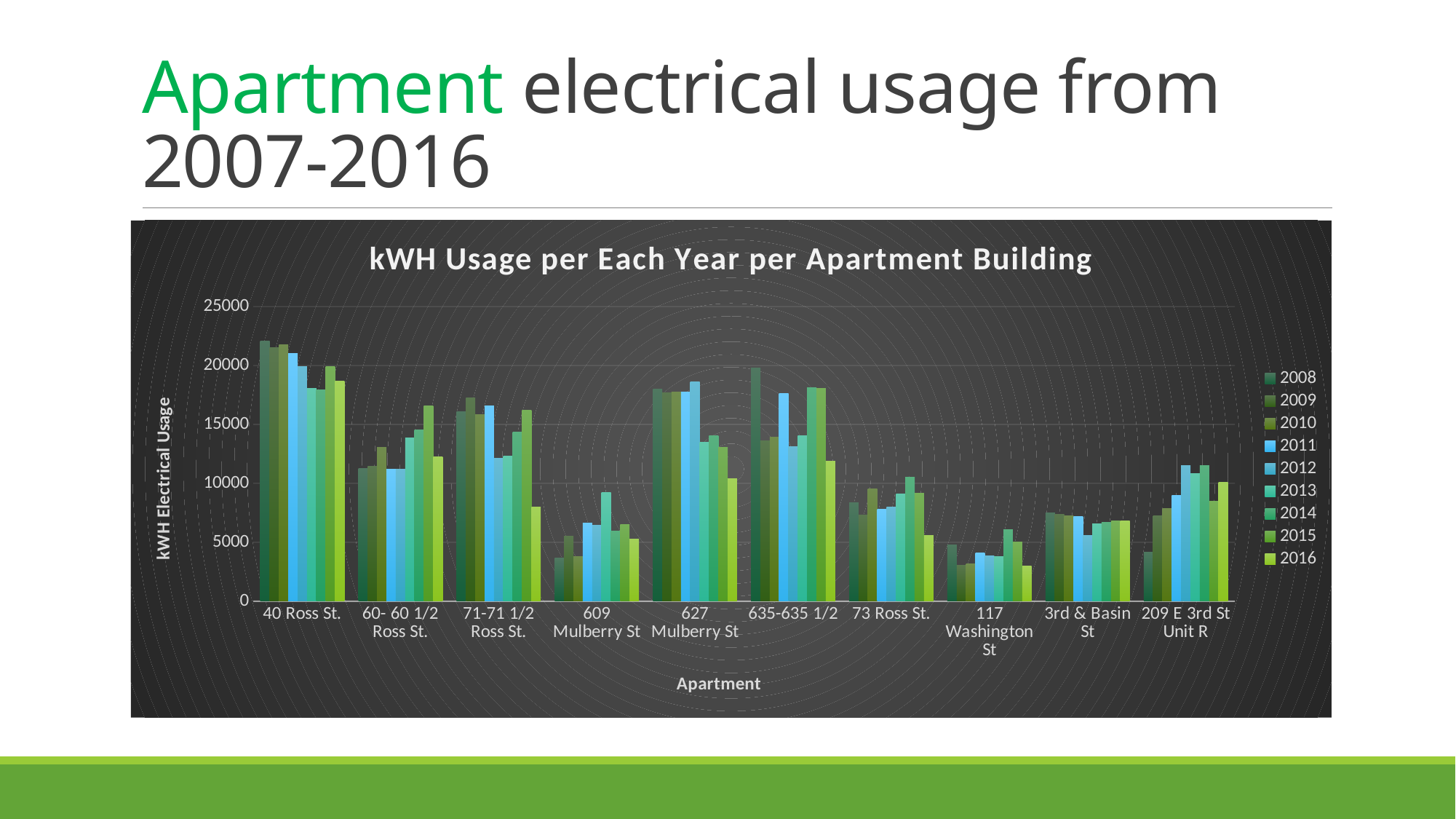
Is the 2008 value for 40 Ross St. greater or less than 20000? greater Is the 2016 value for 117 Washington St greater or less than 5000? less Is the 2008 value for 635-635 1/2 greater or less than 15000? greater How many apartment buildings are shown along the x axis? 10 Which has the larger 2016 usage, 40 Ross St. or 609 Mulberry St? 40 Ross St. What is the title of the chart? kWH Usage per Each Year per Apartment Building What is the label of the vertical axis? kWH Electrical Usage Which apartment building has the lowest 2016 usage? 117 Washington St What kind of chart is shown on the slide? bar chart Which apartment building has the highest 2008 usage? 40 Ross St. How many years (series) does the chart legend list? 9